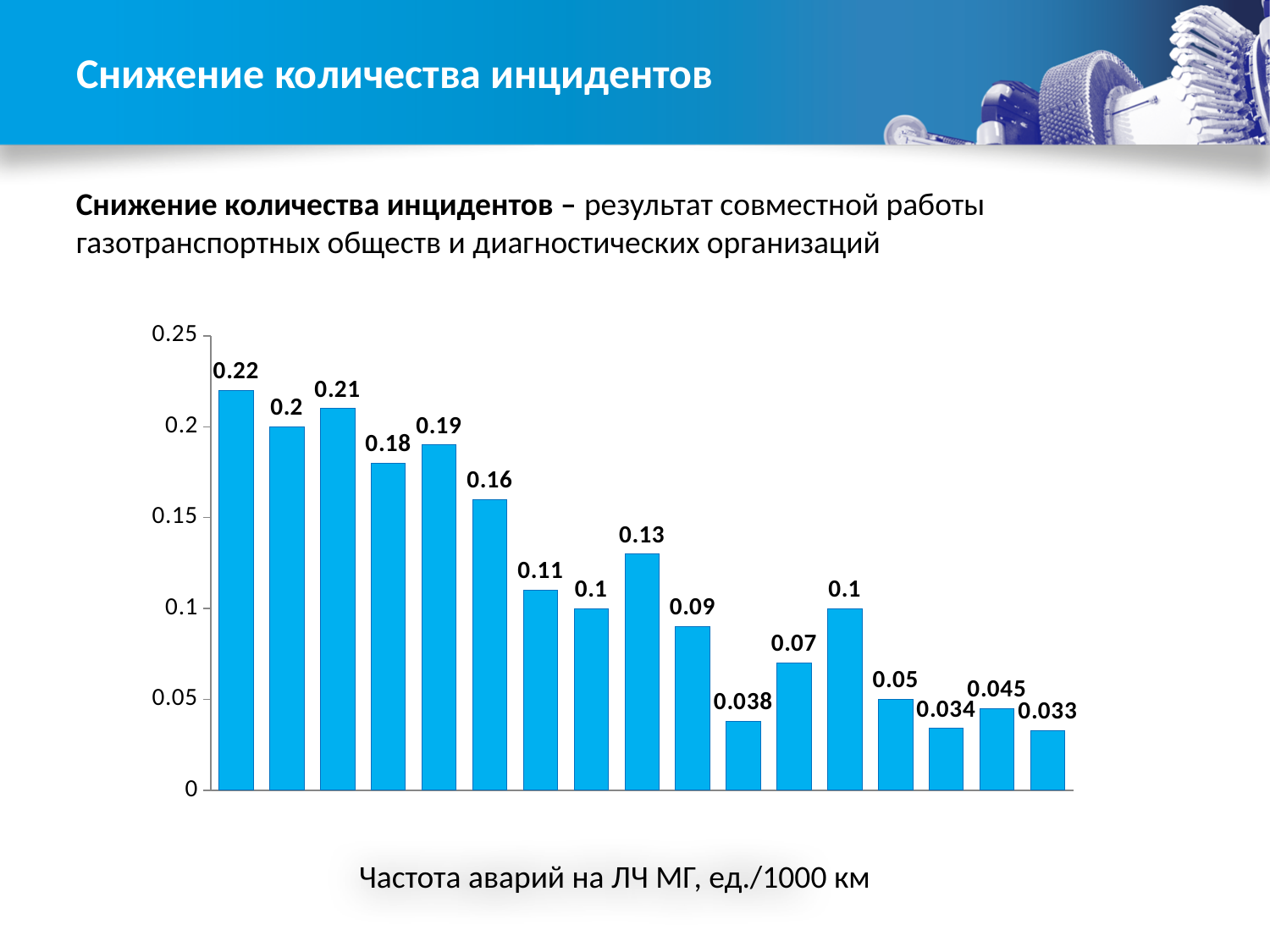
What is the value shown on the first (leftmost) bar of the chart? 0.22 What caption is printed below the chart? Частота аварий на ЛЧ МГ, ед./1000 км What is the value shown on the last (rightmost) bar of the chart? 0.033 Is the value of the sixth bar from the left greater or less than 0.15? greater How many bars are plotted in the chart? 17 What kind of chart is shown on the slide? bar chart What is the highest tick value shown on the vertical axis? 0.25 What is the highest value labelled on any bar in the chart? 0.22 Which is larger: the value of the third bar from the left or the value of the second bar from the left? the third bar (0.21) What is the difference between the first bar's value (0.22) and the last bar's value (0.033)? 0.187 What is the lowest value labelled on any bar in the chart? 0.033 Do the bar values generally rise or fall from left to right across the chart? fall